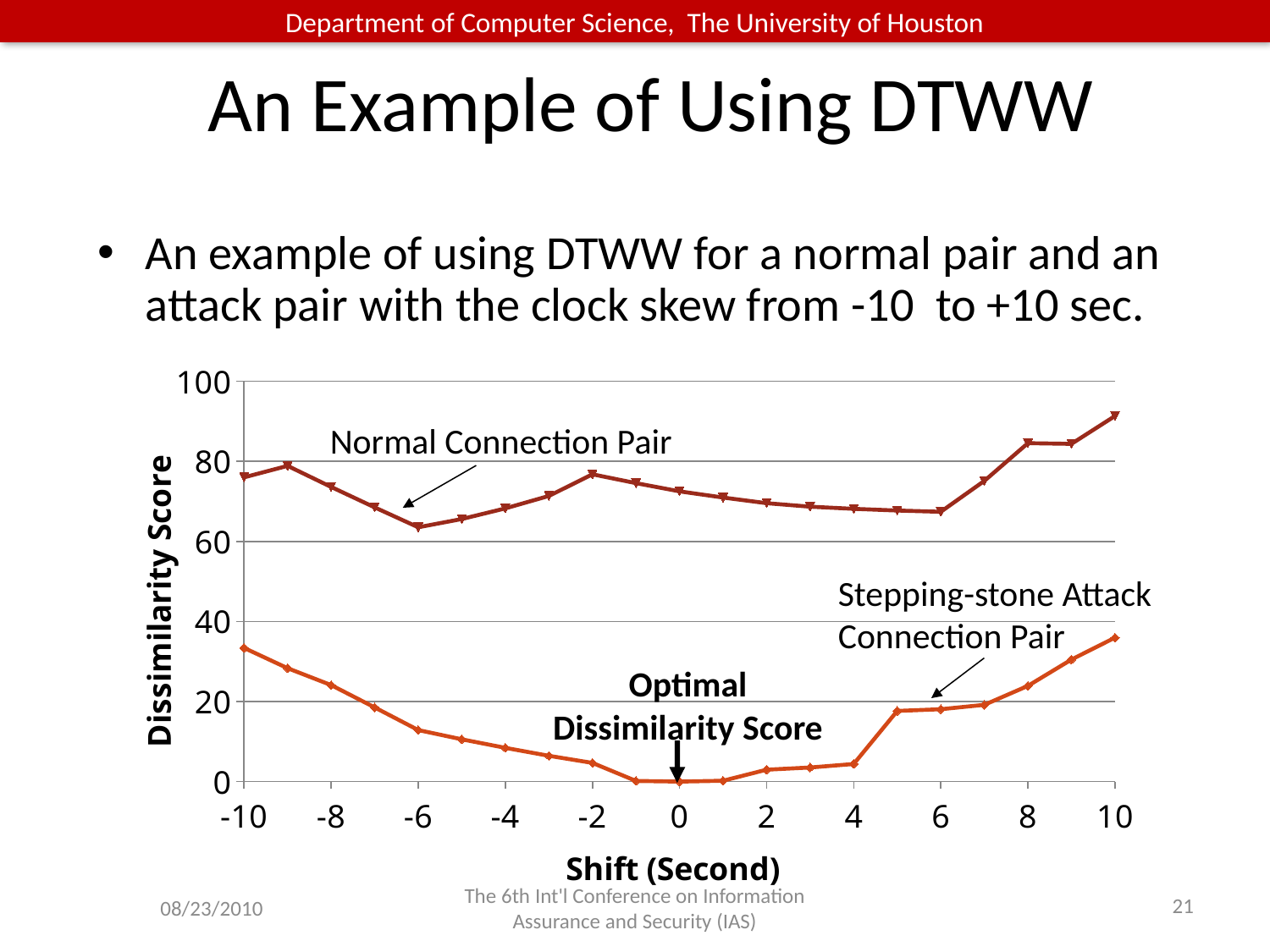
At a shift of 0 seconds, which series has the higher dissimilarity score, the Normal Connection Pair or the Stepping-stone Attack Connection Pair? Normal Connection Pair At which shift does the Stepping-stone Attack Connection Pair reach its highest dissimilarity score? 10 What is the title of the y axis? Dissimilarity Score At which shift does the Normal Connection Pair reach its highest dissimilarity score? 10 What is the title of the x axis? Shift (Second) How many data series are plotted in the chart? 2 Is the dissimilarity score of the Stepping-stone Attack Connection Pair at a shift of -10 greater or less than 40? less What is the dissimilarity score of the Stepping-stone Attack Connection Pair at a shift of 0 seconds? 0 Is the dissimilarity score of the Normal Connection Pair at a shift of 10 greater or less than 80? greater Does the dissimilarity score of the Stepping-stone Attack Connection Pair rise or fall as the shift goes from 0 to 10 seconds? rise What kind of chart is shown on the slide? line chart How many shift values (points) are plotted along the x axis, from -10 to 10? 21